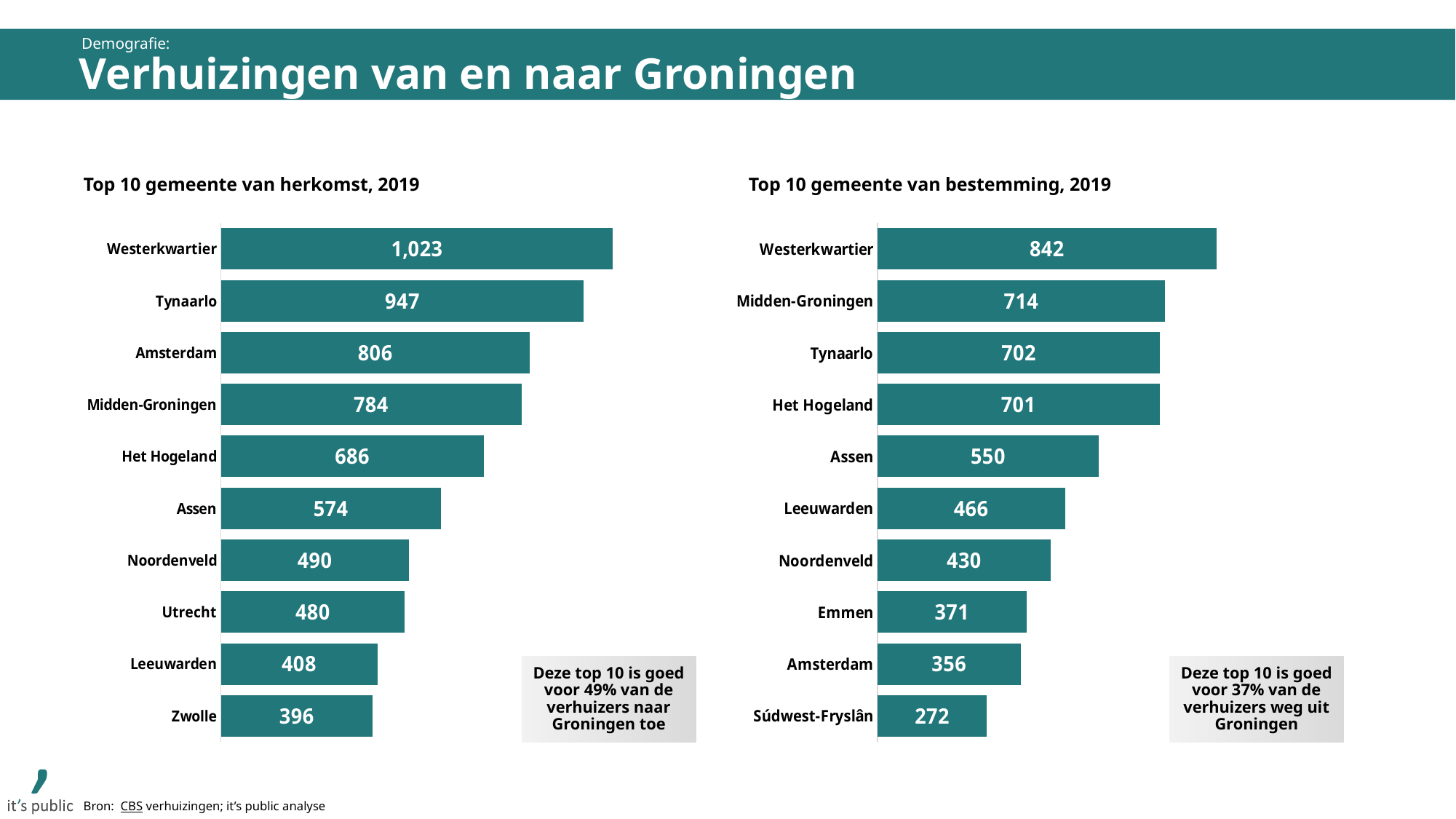
According to the text box on the 'Top 10 gemeente van bestemming, 2019' chart, what share of the verhuizers weg uit Groningen does this top 10 account for? 37% How many gemeenten are shown in the 'Top 10 gemeente van herkomst, 2019' chart? 10 In the 'Top 10 gemeente van bestemming, 2019' chart, which gemeente has the lowest value? Súdwest-Fryslân In the 'Top 10 gemeente van bestemming, 2019' chart, what is the value for Assen? 550 In the 'Top 10 gemeente van bestemming, 2019' chart, what is the difference between the values for Westerkwartier and Midden-Groningen? 128 In the 'Top 10 gemeente van herkomst, 2019' chart, which gemeente has the highest value? Westerkwartier In the 'Top 10 gemeente van bestemming, 2019' chart, which is larger: the value for Emmen or the value for Amsterdam? Emmen In the 'Top 10 gemeente van herkomst, 2019' chart, what is the difference between the values for Westerkwartier and Zwolle? 627 What kind of chart is the 'Top 10 gemeente van bestemming, 2019' chart? Bar chart In the 'Top 10 gemeente van herkomst, 2019' chart, which is larger: the value for Amsterdam or the value for Midden-Groningen? Amsterdam In the 'Top 10 gemeente van herkomst, 2019' chart, what is the value for Utrecht? 480 In the 'Top 10 gemeente van herkomst, 2019' chart, what is the value for Tynaarlo? 947